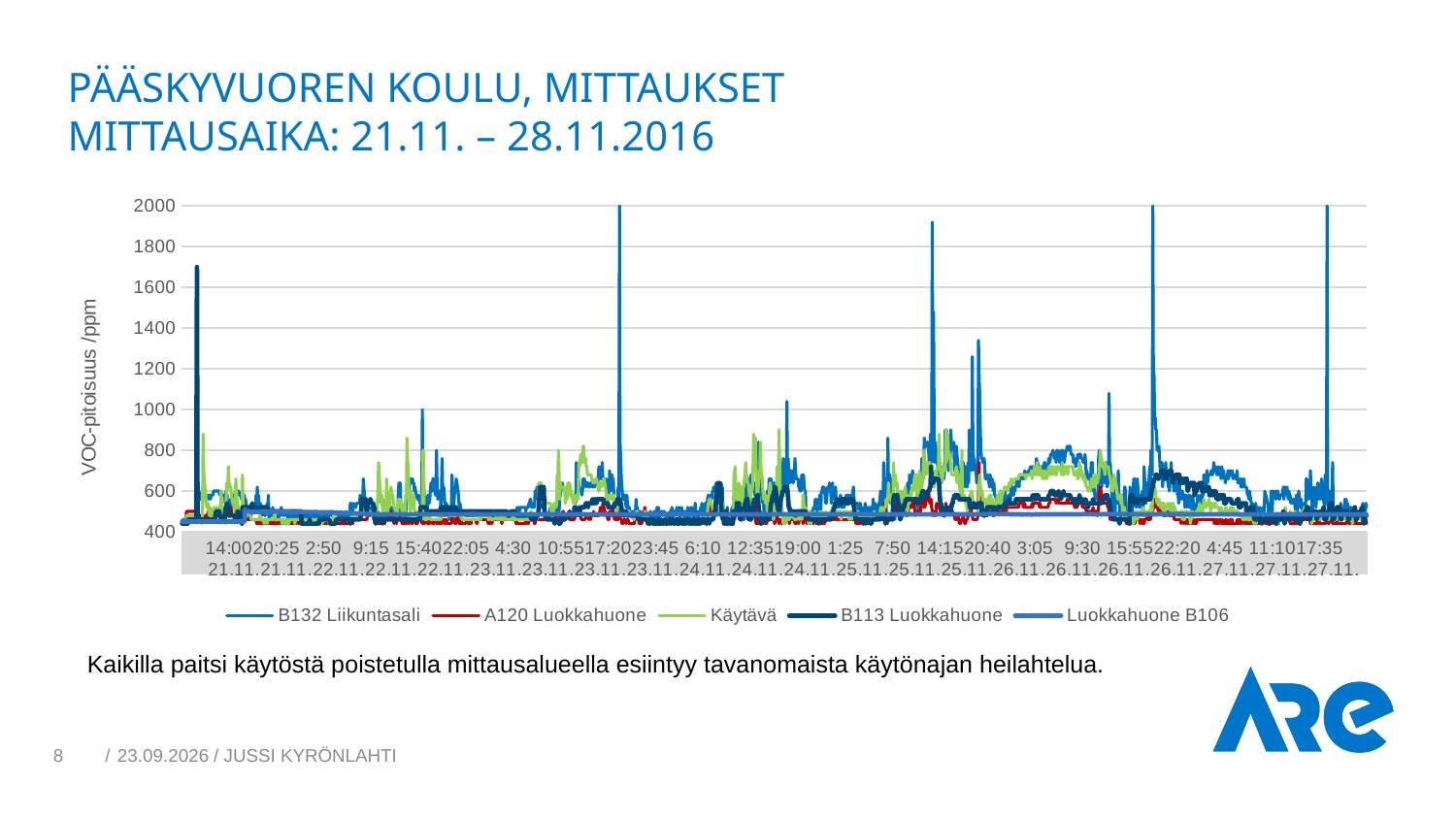
Which series in the chart reaches the highest peak value? B132 Liikuntasali What kind of chart is shown on the slide? Line chart What is the lowest value shown on the vertical axis of the chart? 400 How many series does the legend of the chart list? 5 Is the highest value of the B113 Luokkahuone series greater or less than 1400? greater Is the highest value of the A120 Luokkahuone series greater or less than 1000? less What is the label of the vertical axis of the chart? VOC-pitoisuus /ppm Is the highest value of the Käytävä series greater or less than 1200? less